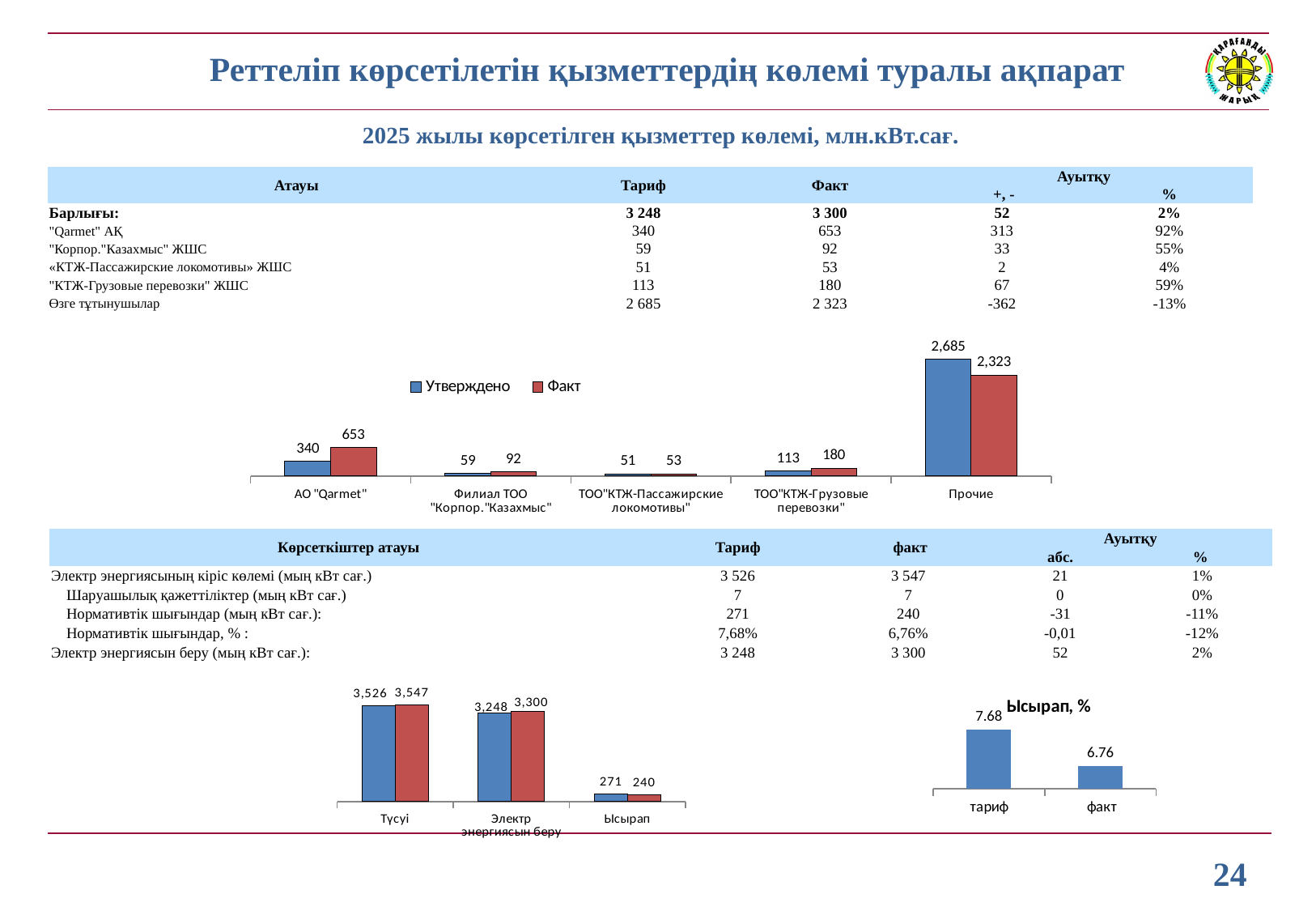
In the top bar chart, what is the difference between the Утверждено and Факт values for Прочие? 362 In the top bar chart, which is larger for Филиал ТОО "Корпор."Казахмыс": the Утверждено value or the Факт value? Факт In the bottom-left bar chart, what is the difference between the two values shown for Ысырап? 31 In the top bar chart, which category has the lowest Утверждено value? ТОО"КТЖ-Пассажирские локомотивы" In the top bar chart, what is the Факт value for АО "Qarmet"? 653 In the top bar chart, how many series does the legend list? 2 In the top bar chart, which category has the highest Факт value? Прочие In the top bar chart, what is the Утверждено value for ТОО"КТЖ-Грузовые перевозки"? 113 In the bottom-right chart titled "Ысырап, %", what is the value for тариф? 7.68 In the bottom-left bar chart, what is the second (red) value for Түсуі? 3,547 What type of chart is the bottom-right chart titled "Ысырап, %"? Bar chart In the top bar chart, how many categories are shown on the x axis? 5